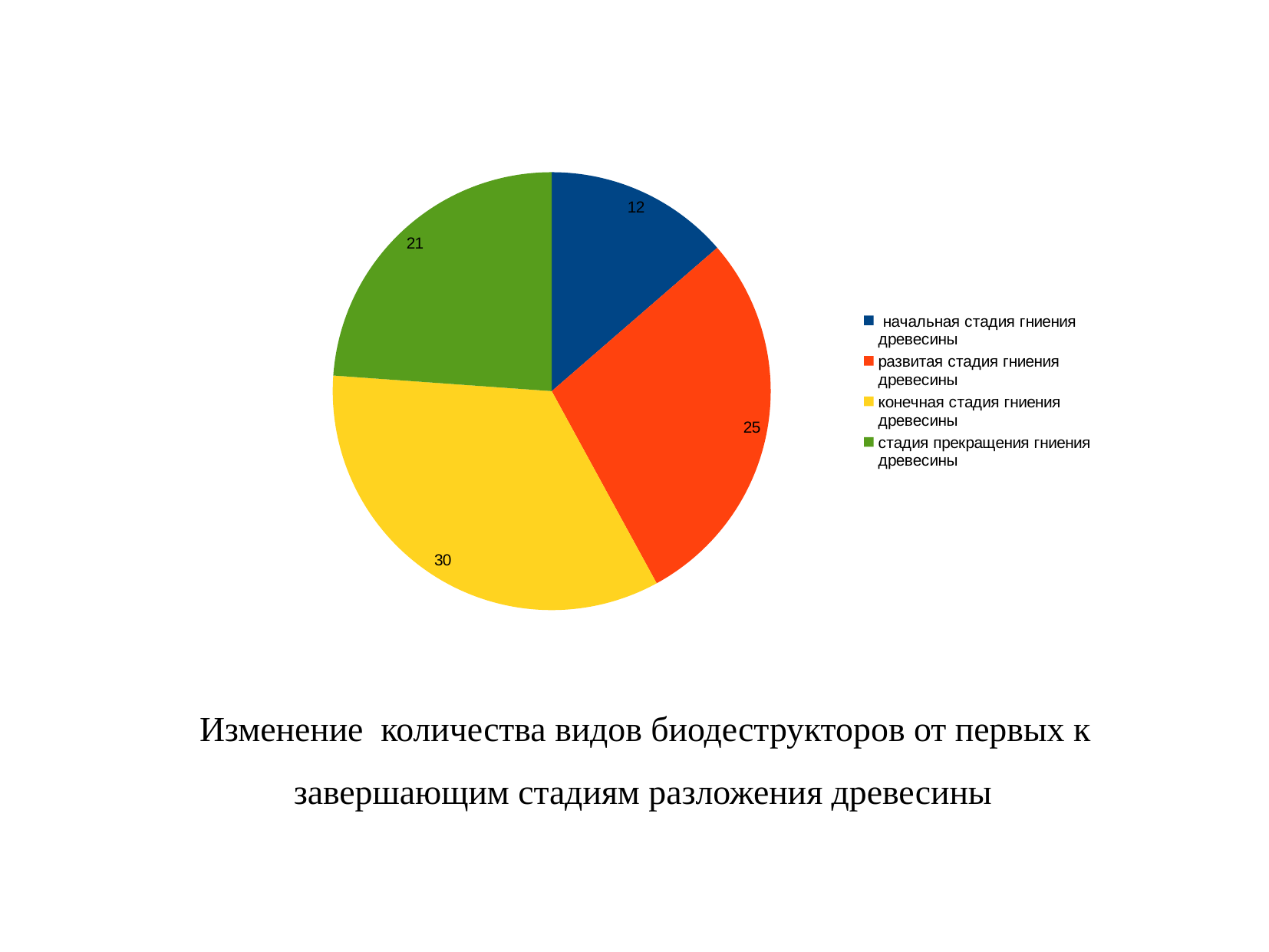
Which category has the largest slice of the pie? конечная стадия гниения древесины What is the value for развитая стадия гниения древесины? 25 What is the value for конечная стадия гниения древесины? 30 What colour is the slice for конечная стадия гниения древесины? yellow What is the difference between the values for конечная стадия гниения древесины and начальная стадия гниения древесины? 18 What type of chart is shown on the slide? pie chart What is the difference between the values for развитая стадия гниения древесины and стадия прекращения гниения древесины? 4 Which is larger: the value for развитая стадия гниения древесины or the value for стадия прекращения гниения древесины? развитая стадия гниения древесины Which category has the smallest slice of the pie? начальная стадия гниения древесины What is the value for начальная стадия гниения древесины? 12 What is the value for стадия прекращения гниения древесины? 21 How many slices does the pie chart have? 4